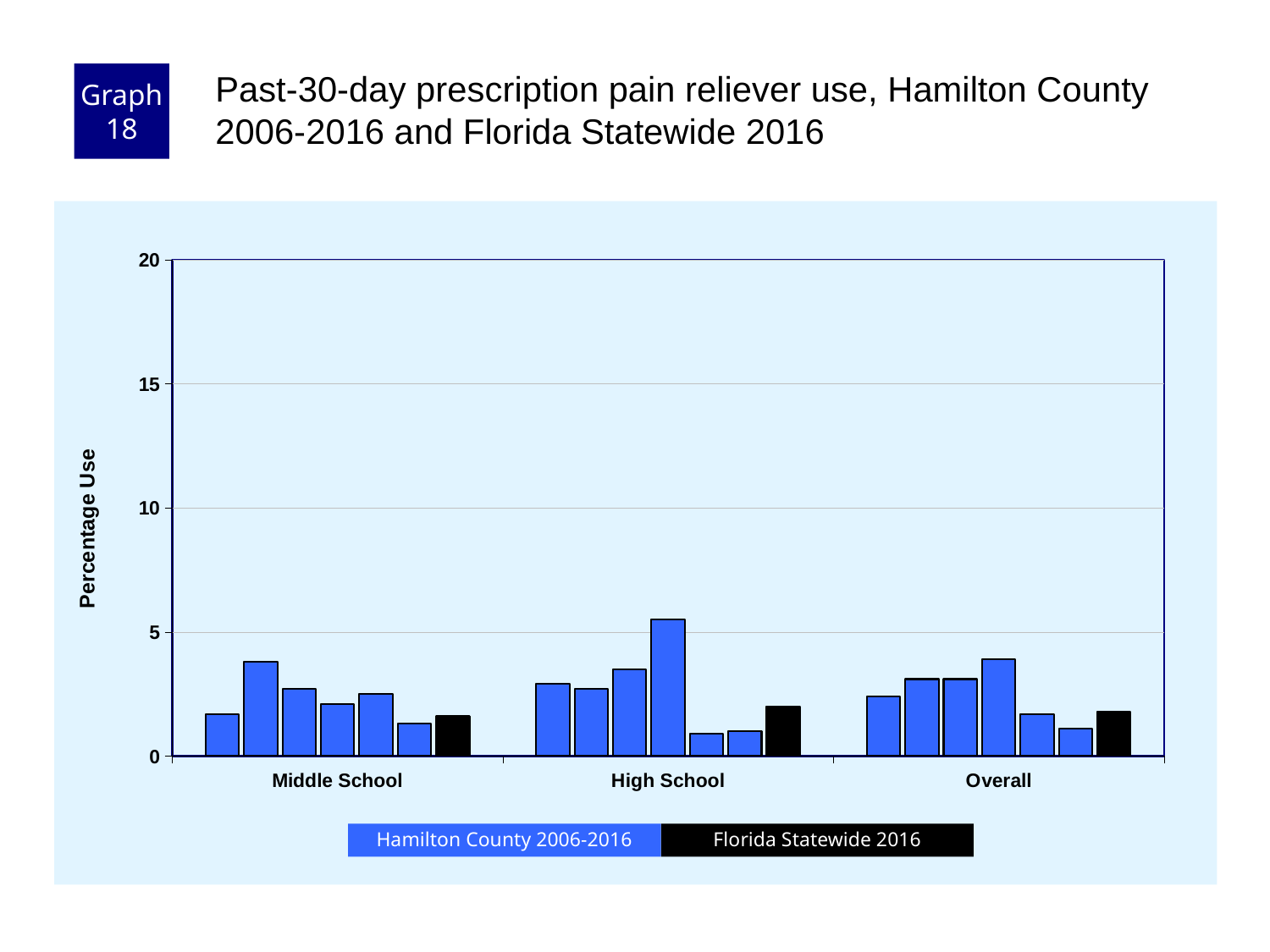
What is the highest value shown on the y axis? 20 How many category groups are shown on the x axis? 3 In the High School group, is the Florida Statewide 2016 bar taller or shorter than the tallest Hamilton County bar? shorter Is the Florida Statewide 2016 value for High School greater or less than 5? less What is the label of the y axis? Percentage Use Is any bar in the chart greater than 10? No How many series does the legend list? 2 Is the tallest bar in the High School group greater or less than 5? greater What kind of chart is shown on the slide? bar chart Which category group contains the tallest bar in the chart? High School